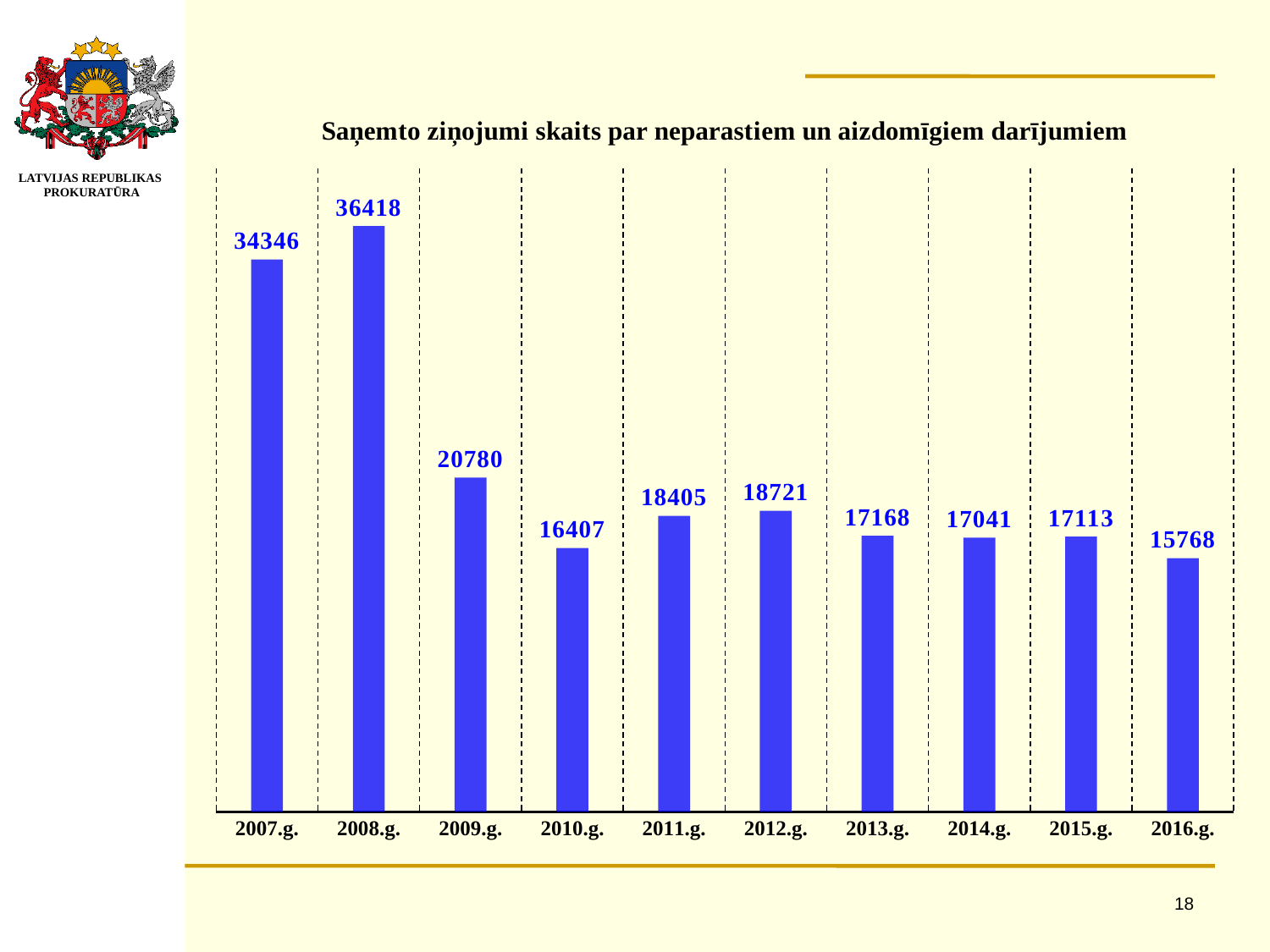
What is the difference between the values for 2007.g. and 2008.g.? 2072 What is the difference between the values for 2008.g. and 2009.g.? 15638 Do the values rise or fall from 2007.g. to 2010.g.? Fall What is the value for 2012.g.? 18721 What is the value for 2008.g.? 36418 Which year has the highest value? 2008.g. Which is larger, the value for 2011.g. or the value for 2012.g.? 2012.g. What is the value for 2016.g.? 15768 What kind of chart is shown on the slide? Bar chart Which year has the lowest value? 2016.g. How many years are shown on the x axis? 10 What is the title of the chart? Saņemto ziņojumi skaits par neparastiem un aizdomīgiem darījumiem